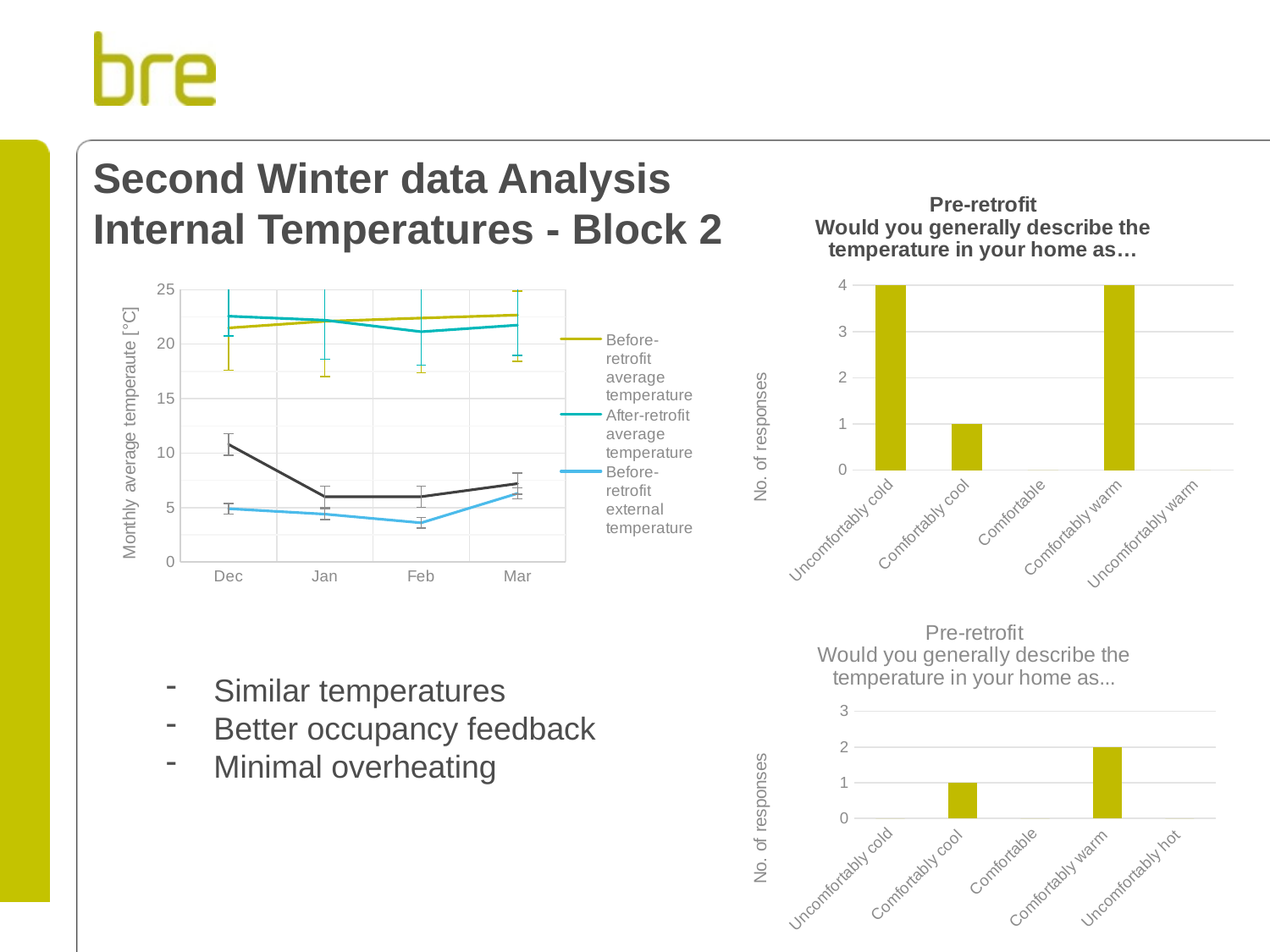
In the line chart on the left, how many series does the legend list? 3 In the bottom-right bar chart, how many responses are there for 'Comfortably warm'? 2 In the line chart on the left, how many months are shown on the x axis? 4 In the top-right bar chart (bold 'Pre-retrofit' title), what is the difference in responses between 'Uncomfortably cold' and 'Comfortably cool'? 3 What kind of chart is the chart on the left of the slide showing monthly average temperature? line chart In the top-right bar chart (bold 'Pre-retrofit' title), how many responses are there for 'Comfortably cool'? 1 In the top-right bar chart (bold 'Pre-retrofit' title), how many responses are there for 'Uncomfortably cold'? 4 In the line chart on the left, is the Before-retrofit external temperature for Feb greater or less than 5? less In the line chart on the left, is the After-retrofit average temperature for Dec greater or less than 20? greater In the top-right bar chart (bold 'Pre-retrofit' title), how many categories are shown on the x axis? 5 What kind of chart is the top-right chart on the slide? bar chart In the bottom-right bar chart, which category has the highest number of responses? Comfortably warm